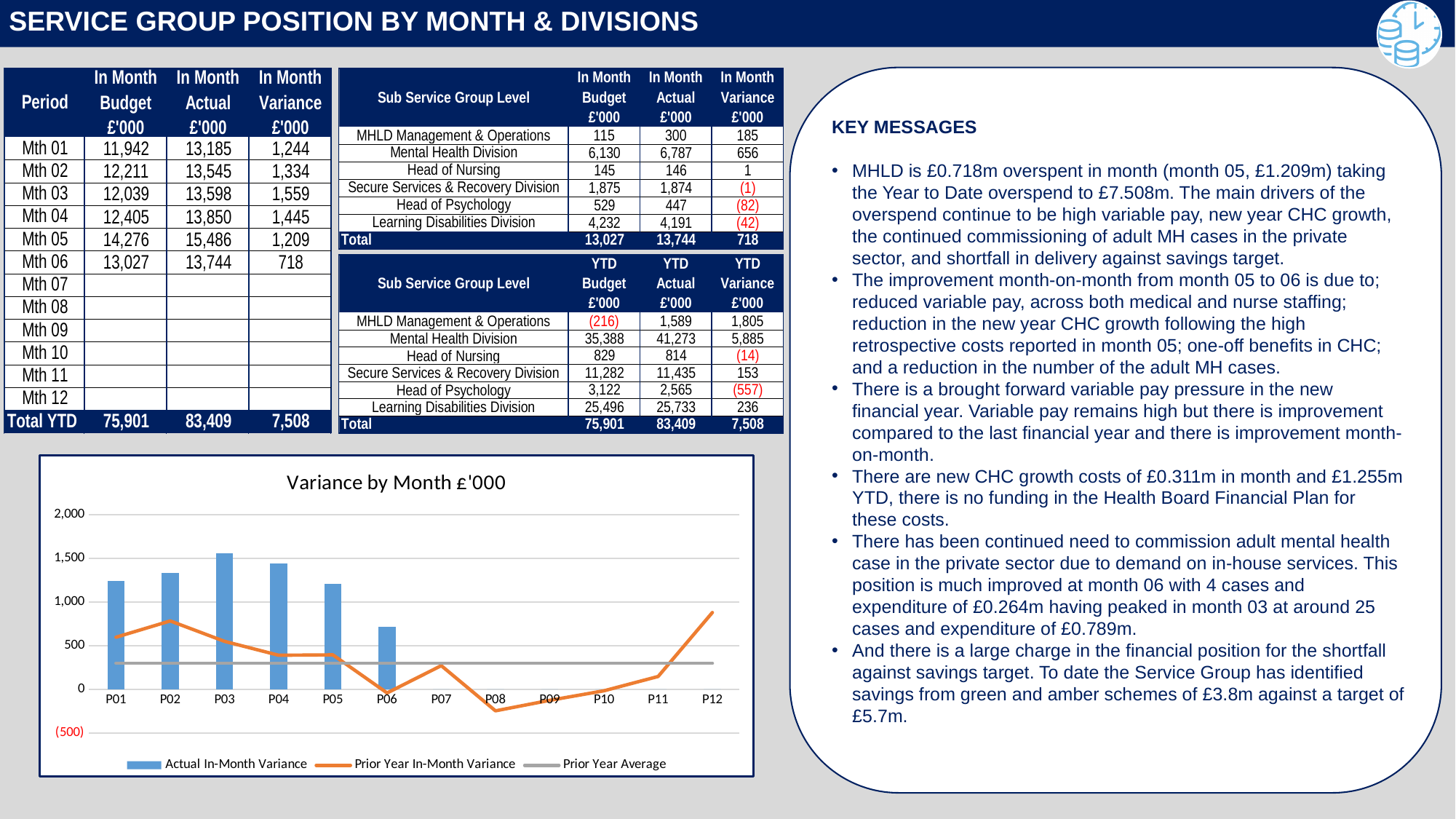
How many periods have an Actual In-Month Variance bar plotted? 6 How many periods are labelled on the x axis of the chart? 12 What is the title of the chart? Variance by Month £'000 Among the periods with bars, which has the lowest Actual In-Month Variance? P06 How many series does the chart legend list? 3 Is the Prior Year In-Month Variance at P08 greater or less than 0? less Do the Actual In-Month Variance bars rise or fall from P03 to P06? fall Is the Actual In-Month Variance bar for P06 greater or less than 1,000? less Is the Actual In-Month Variance bar for P04 larger or smaller than the bar for P06? larger What kind of chart is shown on the slide? Bar chart with line series Is the Actual In-Month Variance bar for P03 greater or less than 1,500? greater Which period has the highest Actual In-Month Variance bar? P03